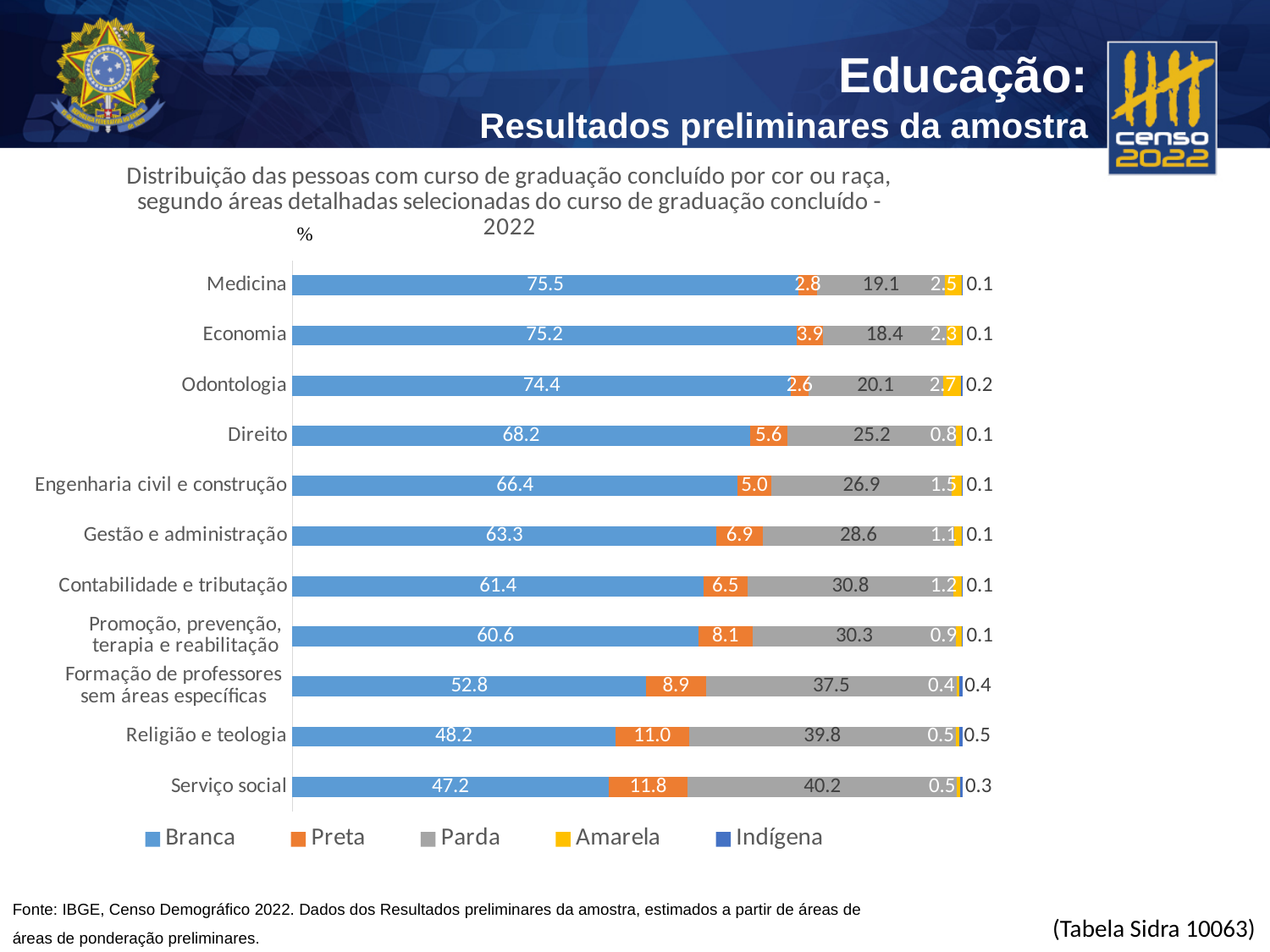
How many series does the legend list? 5 What is the difference between the Branca value for Medicina and the Branca value for Serviço social? 28.3 Which category has the lowest Branca value? Serviço social What is the Preta value for Religião e teologia? 11.0 What kind of chart is shown on the slide? Stacked bar chart How many categories (areas of study) are shown in the chart? 11 Which category has the highest Preta value? Serviço social What is the Amarela value for Odontologia? 2.7 Which is larger: the Parda value for Direito or the Parda value for Gestão e administração? Gestão e administração What is the Parda value for Serviço social? 40.2 What is the Branca value for Medicina? 75.5 What is the total of the stacked bar for Medicina? 100.0